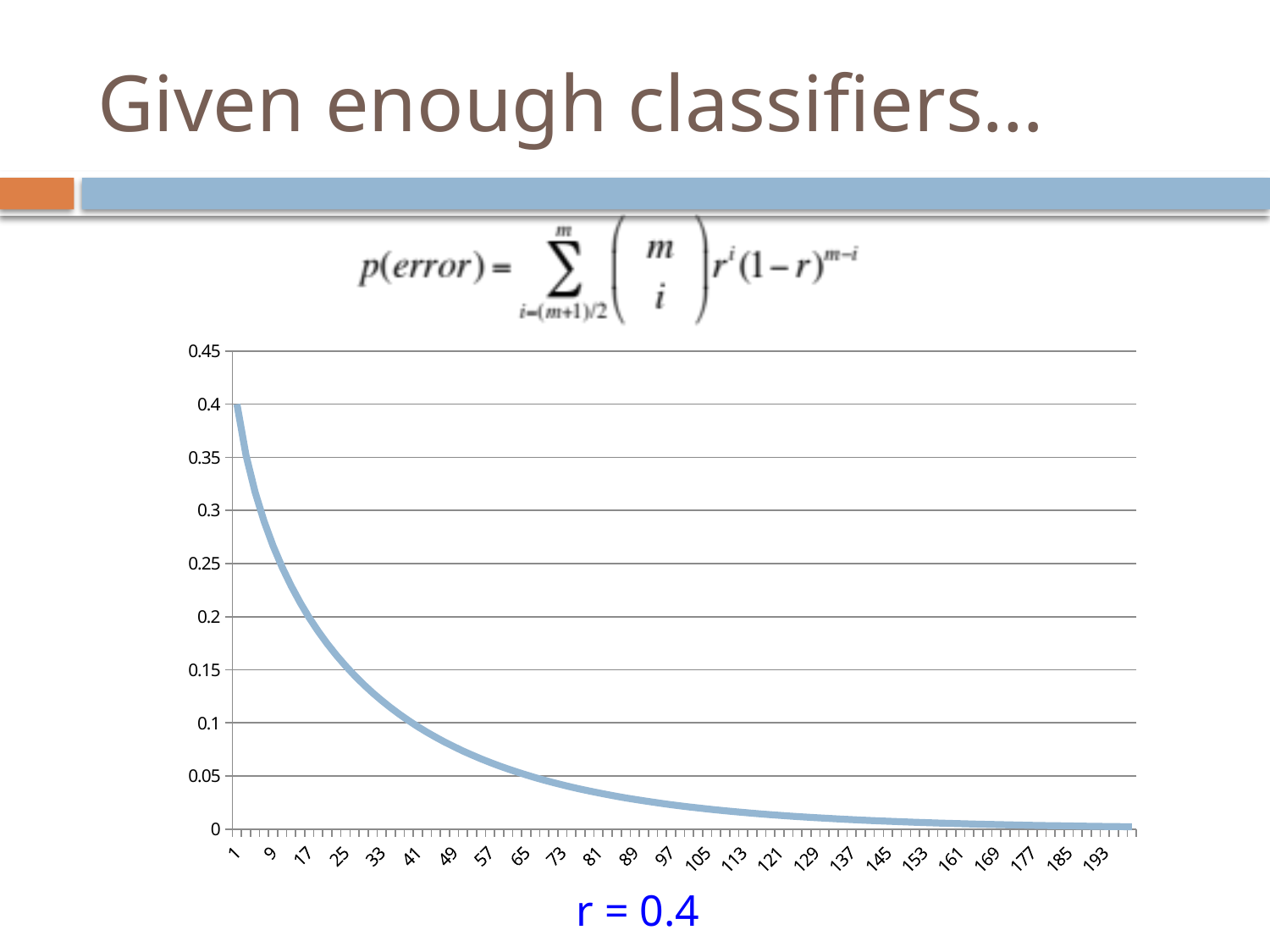
Is the plotted value at x = 9 greater or less than 0.2? greater Does the plotted value rise or fall as the x-axis value increases? fall How many labels are printed on the x axis? 25 Is the plotted value at x = 41 greater or less than 0.15? less At which x-axis label is the plotted value lowest? 193 At which x-axis label is the plotted value highest? 1 What value of r is stated below the chart? r = 0.4 What is the highest value shown on the y axis? 0.45 What kind of chart is shown on the slide? line chart What is the plotted value at x = 1? 0.4 Is the plotted value at x = 17 larger or smaller than the value at x = 65? larger Is the plotted value at x = 97 greater or less than 0.05? less